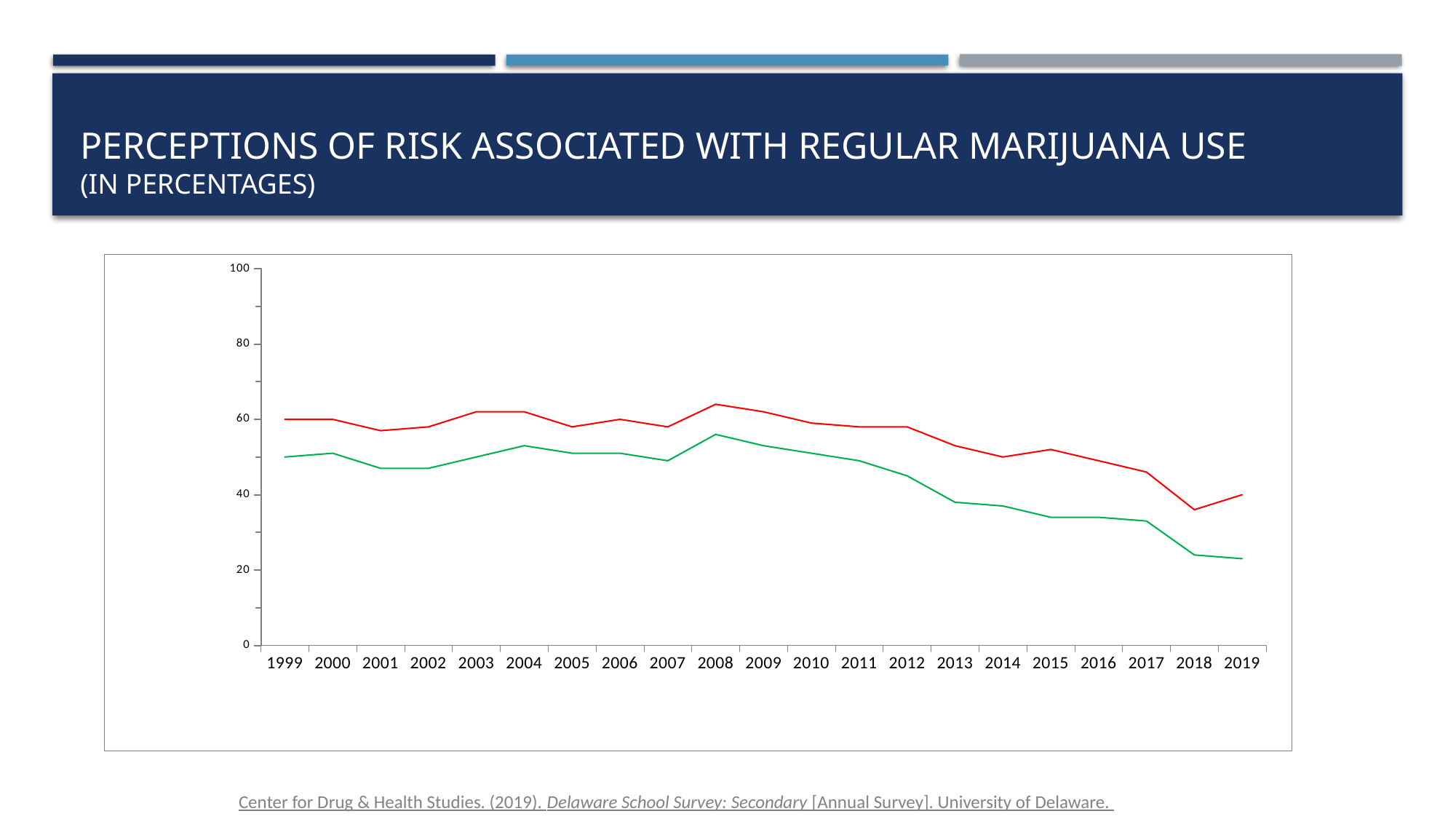
In which year does the red line reach its lowest value? 2018 Overall, do the values of the green line rise or fall from 1999 to 2019? fall What kind of chart is shown on the slide? line chart What is the title of the slide containing the chart? Perceptions of Risk Associated with Regular Marijuana Use (in percentages) Is the value of the red line in 2018 greater or less than 40? less Overall, do the values of the red line rise or fall from 1999 to 2019? fall Is the value of the red line in 2008 greater or less than 60? greater Is the value of the green line in 2019 greater or less than 40? less How many lines are plotted on the chart? 2 How many years are plotted along the x axis of the chart? 21 In 2019, which line has the higher value, the red line or the green line? the red line